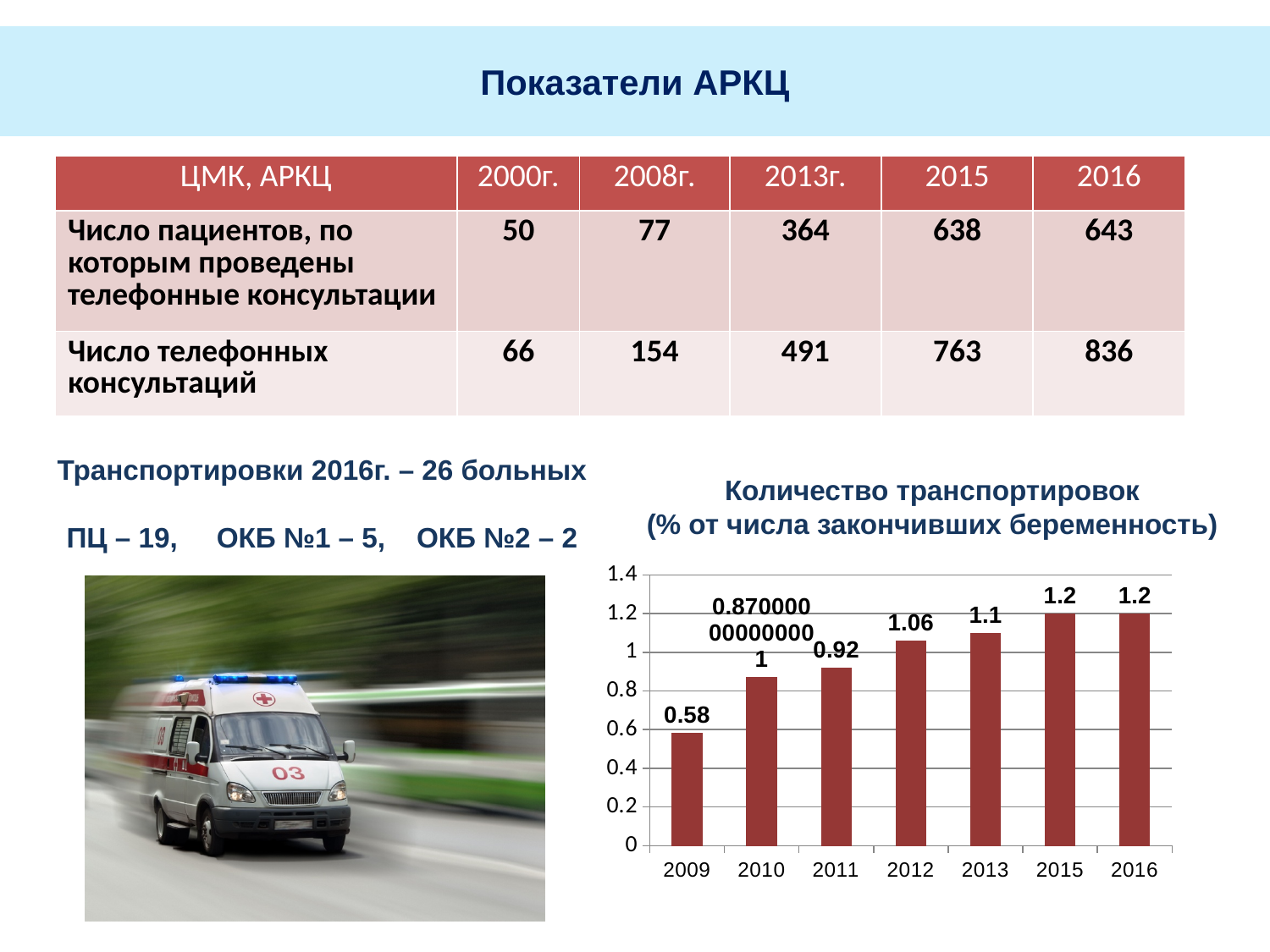
Which is larger, the value for 2011 or the value for 2013? 2013 What is the difference between the values for 2012 and 2009? 0.48 What is the value for 2009 in the chart? 0.58 What is the value for 2013 in the chart? 1.1 What type of chart is shown on the slide? bar chart How many years are shown on the x axis of the chart? 7 What is the value for 2016 in the chart? 1.2 Is the value for 2010 greater or less than 0.8? greater What is the value for 2012 in the chart? 1.06 Which year has the lowest value in the chart? 2009 What is the value for 2011 in the chart? 0.92 Do the values in the chart rise or fall from 2009 to 2016? rise